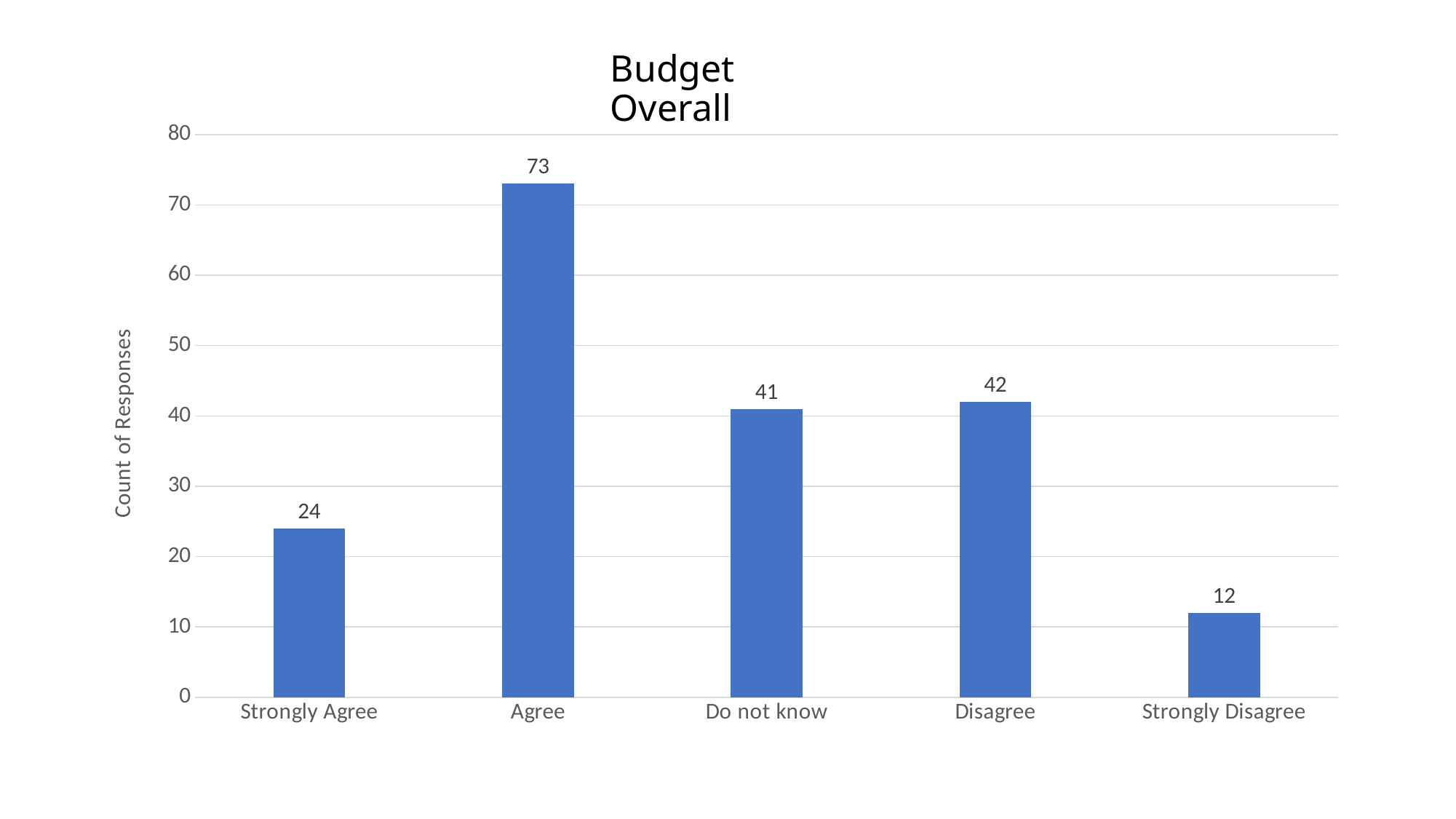
Which has more responses, Strongly Agree or Do not know? Do not know What is the title of the chart? Budget Overall Which category has the lowest count of responses? Strongly Disagree What is the count of responses for Strongly Disagree? 12 Is the value for Agree greater or less than 70? greater What is the difference between the counts for Strongly Agree and Strongly Disagree? 12 What is the difference between the counts for Agree and Disagree? 31 How many categories are shown on the x axis? 5 What is the count of responses for Do not know? 41 What is the count of responses for Agree? 73 Which category has the highest count of responses? Agree What kind of chart is shown on the slide? Bar chart